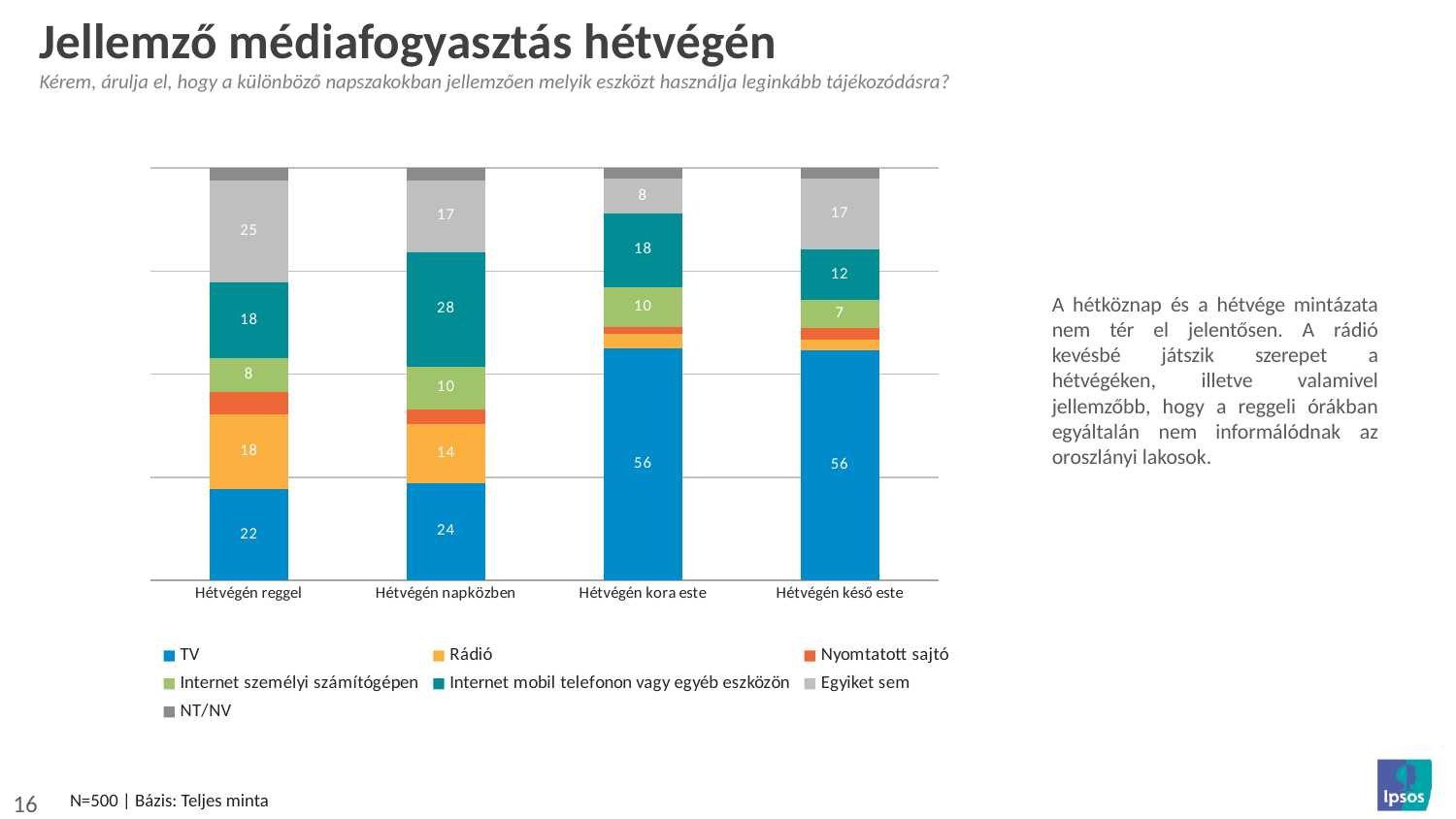
What is the Egyiket sem value for Hétvégén kora este? 8 Which is larger: the Internet mobil telefonon vagy egyéb eszközön value for Hétvégén napközben or for Hétvégén késő este? Hétvégén napközben What is the Rádió value for Hétvégén napközben? 14 What is the title of the slide's chart? Jellemző médiafogyasztás hétvégén What is the Internet mobil telefonon vagy egyéb eszközön value for Hétvégén napközben? 28 What is the difference between the TV values for Hétvégén kora este and Hétvégén reggel? 34 Which category has the highest TV value? Hétvégén kora este and Hétvégén késő este (both 56) Which category has the lowest Egyiket sem value? Hétvégén kora este How many series does the legend list? 7 What is the TV value for Hétvégén reggel? 22 What kind of chart is shown on the slide? Stacked bar chart How many categories are shown on the x axis? 4